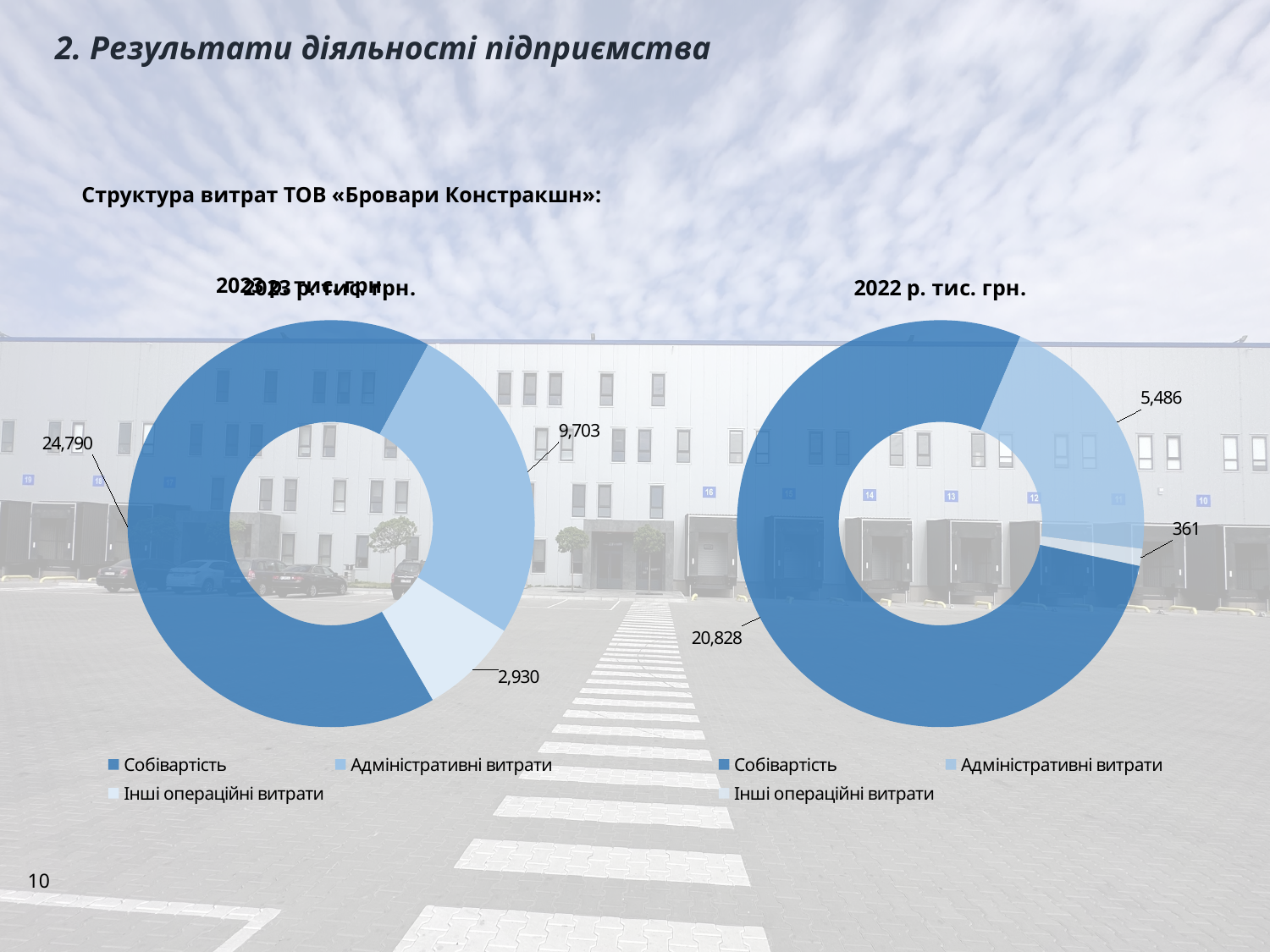
In the chart titled "2022 р. тис. грн.", what is the value for Собівартість? 20,828 How many categories does the legend of the chart titled "2022 р. тис. грн." list? 3 In the left chart, what is the value for Адміністративні витрати? 9,703 In the left chart, what is the value for Собівартість? 24,790 In the chart titled "2022 р. тис. грн.", what is the value for Інші операційні витрати? 361 In the chart titled "2022 р. тис. грн.", which category has the largest value? Собівартість What kind of chart is the chart titled "2022 р. тис. грн."? Doughnut (pie) chart In the left chart, what is the value for Інші операційні витрати? 2,930 In the chart titled "2022 р. тис. грн.", what is the value for Адміністративні витрати? 5,486 In the left chart, which category has the smallest value? Інші операційні витрати Which is larger: Адміністративні витрати in the left chart or Адміністративні витрати in the chart titled "2022 р. тис. грн."? The left chart What is the difference between Собівартість in the left chart (24,790) and Собівартість in the chart titled "2022 р. тис. грн." (20,828)? 3,962